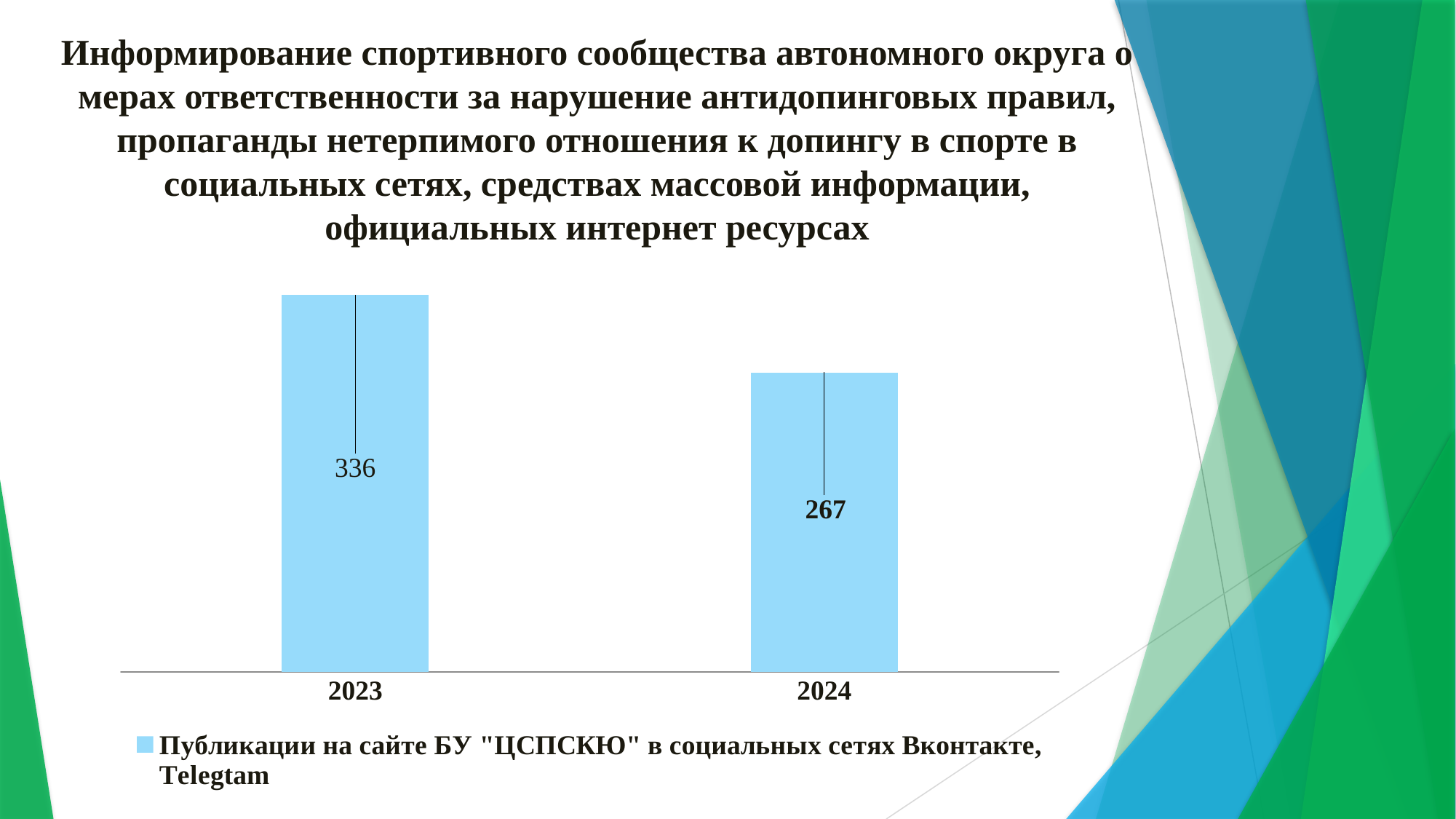
What is the difference between the values for 2023 and 2024? 69 Which is larger, the value for 2023 or the value for 2024? 2023 What is the value for 2023? 336 What colour are the bars in the chart? light blue Which year has the highest value? 2023 What kind of chart is shown on the slide? bar chart What is the total of the values for 2023 and 2024? 603 Which year has the lowest value? 2024 How many categories are shown on the x axis? 2 What is the value for 2024? 267 How many series does the legend list? 1 Do the values rise or fall from 2023 to 2024? fall